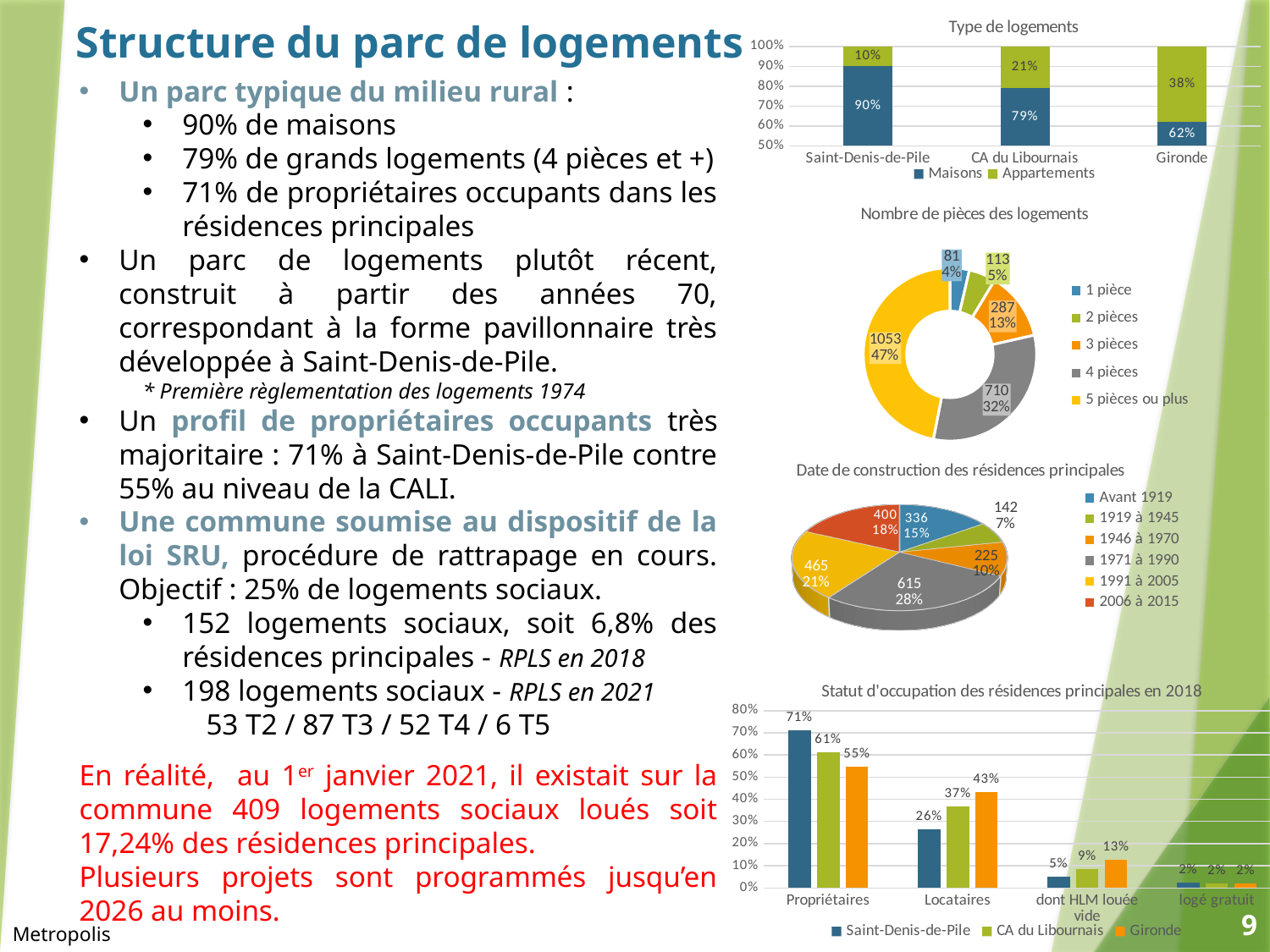
In the 'Date de construction des résidences principales' chart, which is larger: the value for 1991 à 2005 or for 2006 à 2015? 1991 à 2005 In the 'Type de logements' chart, what is the difference between the Maisons share in Saint-Denis-de-Pile and in CA du Libournais? 11% In the 'Date de construction des résidences principales' chart, how many categories does the legend list? 6 In the 'Nombre de pièces des logements' chart, what share of the total is '5 pièces ou plus'? 47% What kind of chart is 'Statut d'occupation des résidences principales en 2018'? Bar chart In the 'Type de logements' chart, what is the value for Maisons in Saint-Denis-de-Pile? 90% In the 'Statut d'occupation des résidences principales en 2018' chart, what is the value for Locataires in Gironde? 43% In the 'Statut d'occupation des résidences principales en 2018' chart, how many series does the legend list? 3 In the 'Nombre de pièces des logements' chart, which category has the smallest share? 1 pièce In the 'Nombre de pièces des logements' chart, how many logements have 4 pièces? 710 In the 'Type de logements' chart, which area has the highest share of Appartements? Gironde In the 'Date de construction des résidences principales' chart, how many résidences principales were built between 1971 and 1990? 615